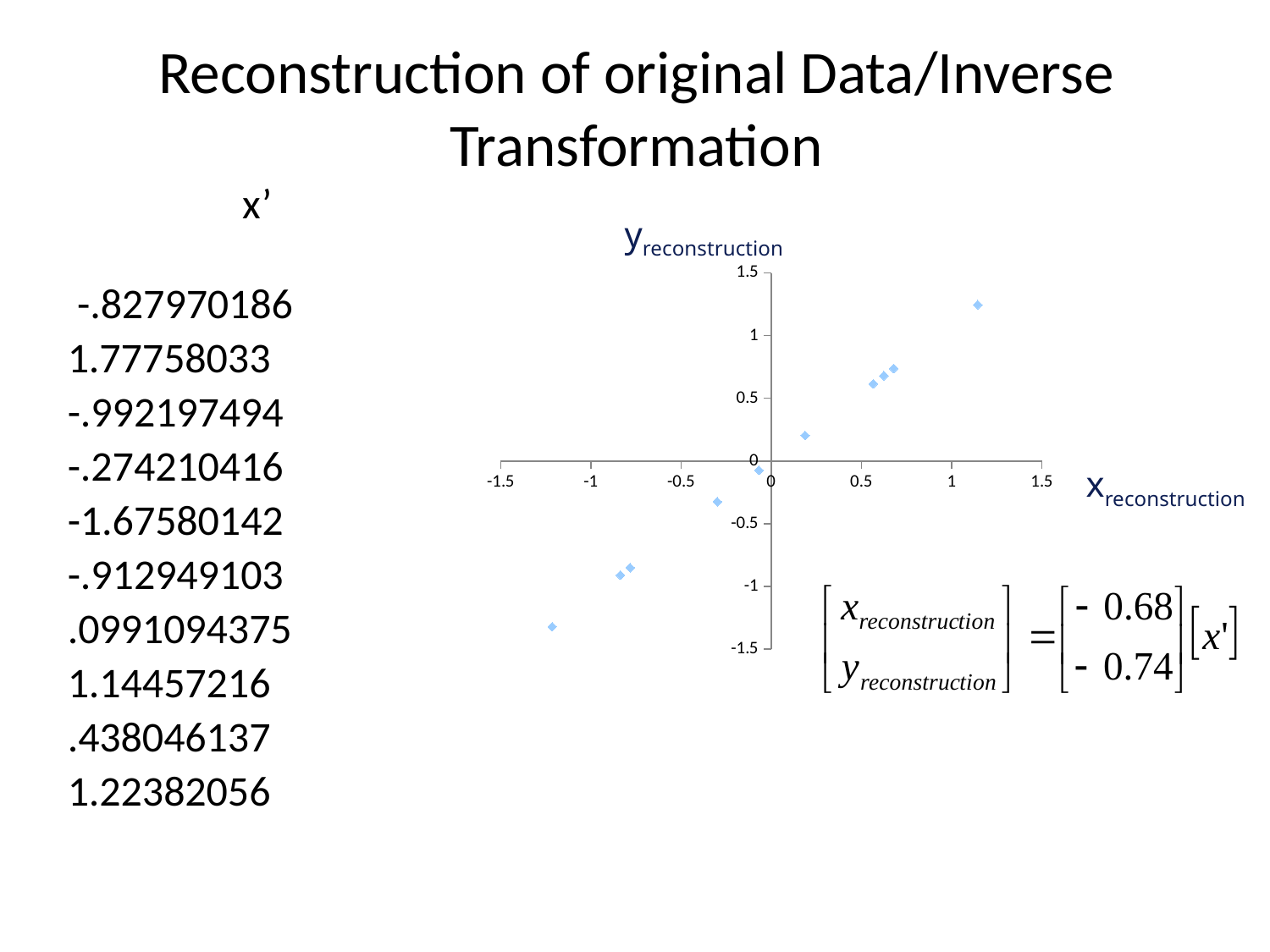
Is the y_reconstruction value of the highest plotted point greater or less than 1? greater What is the label of the vertical axis of the chart? y_reconstruction How many data points are plotted in the scatter chart? 10 How many plotted points have a negative y_reconstruction value? 5 Is the y_reconstruction value of the lowest plotted point greater or less than -1? less Do the plotted points rise or fall as x_reconstruction increases? rise What kind of chart is shown on the slide? scatter chart Is the x_reconstruction value of the leftmost plotted point greater or less than -1? less What is the maximum tick value shown on the horizontal axis of the chart? 1.5 How many plotted points have a positive x_reconstruction value? 5